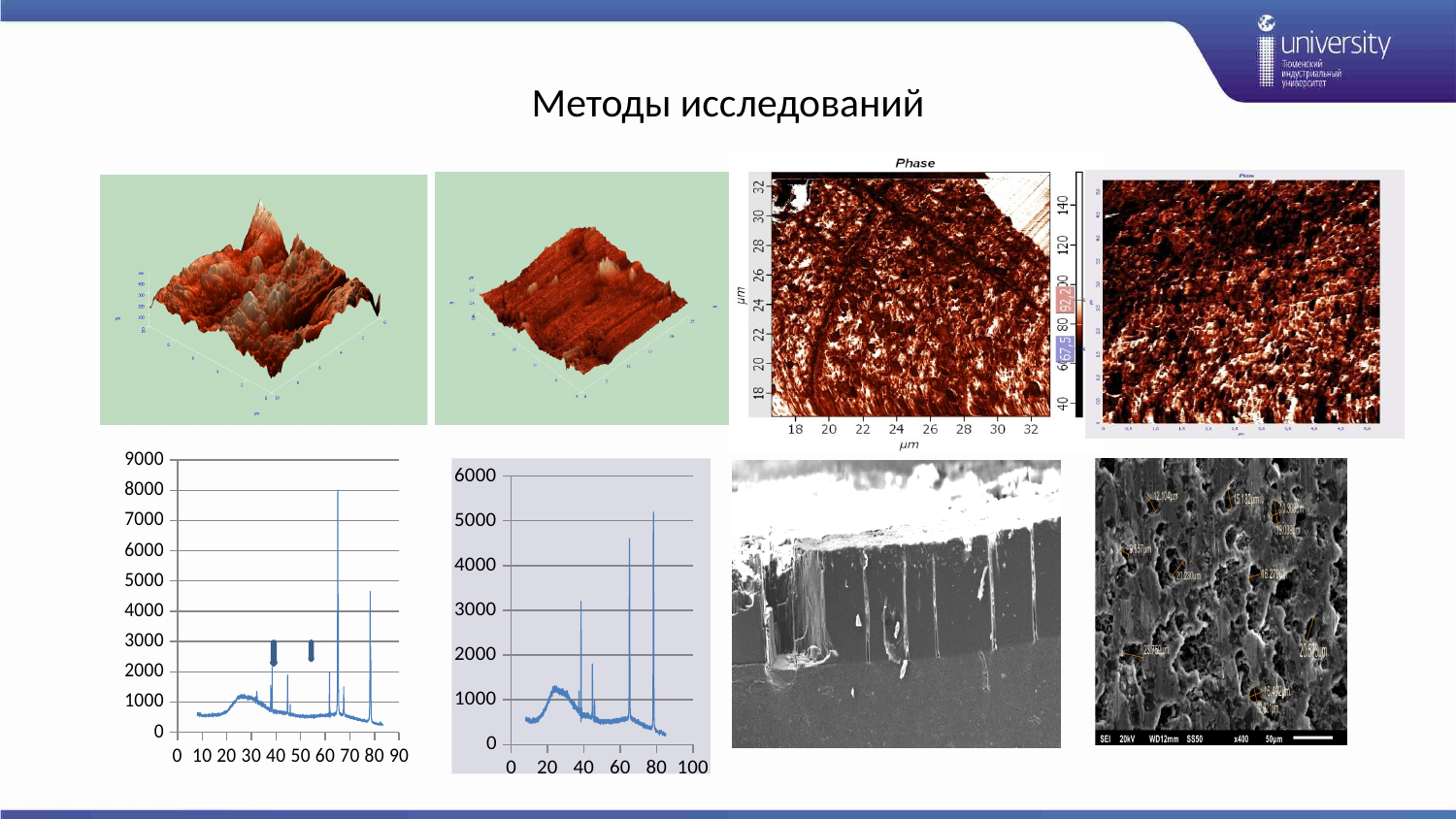
On the bottom-middle chart, is the peak near x = 65 greater or less than 5000? less What is the highest tick value on the x axis of the bottom-middle chart? 100 On the bottom-middle chart, is the tallest peak (near x = 80) greater or less than 4000? greater What kind of chart is the bottom-left chart on the slide? line chart What kind of chart is the bottom-middle chart (with the y axis up to 6000)? line chart What is the highest tick value on the y axis of the bottom-left chart? 9000 On the bottom-middle chart, is the peak near x = 40 greater or less than 2000? greater How many line charts are shown on the slide? 2